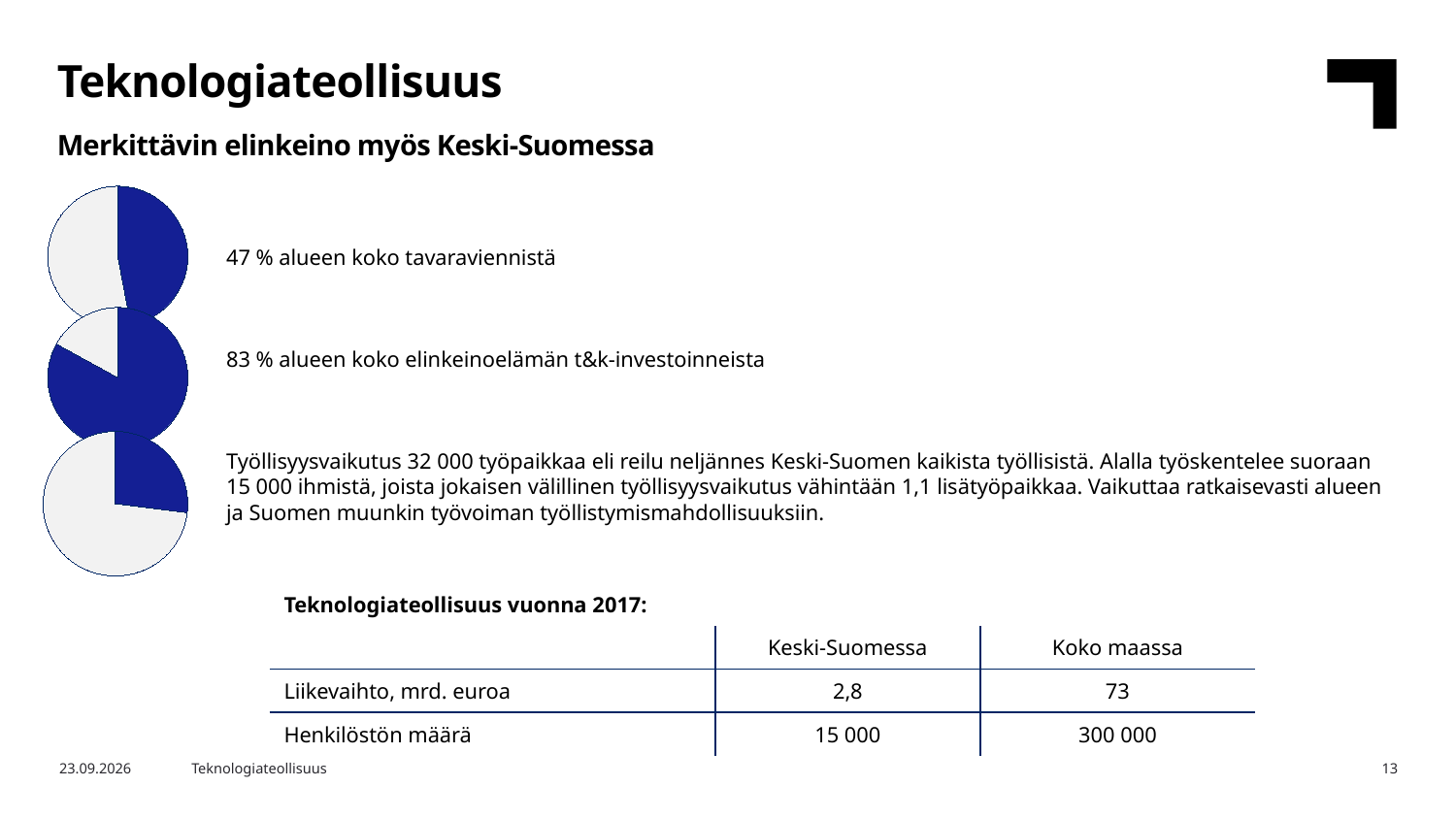
Which of the three pie charts has the smallest highlighted (dark blue) slice? The bottom pie chart In the bottom pie chart, is the highlighted slice greater or less than 50 %? less In the middle pie chart, is the highlighted slice greater or less than 50 %? greater How many slices does each pie chart have? 2 In the middle pie chart, what share of the region's business R&D investments does the highlighted slice represent? 83 % Is the highlighted slice in the top pie chart larger or smaller than the highlighted slice in the middle pie chart? Smaller How many pie charts are on the slide? 3 What kind of charts are shown on the left side of the slide? Pie charts Which of the three pie charts has the largest highlighted (dark blue) slice? The middle pie chart In the top pie chart, what share of the region's total goods exports does the highlighted slice represent? 47 % What is the difference in percentage points between the highlighted shares of the middle pie chart (83 %) and the top pie chart (47 %)? 36 percentage points What colour is used for the highlighted slice in each pie chart? Dark blue